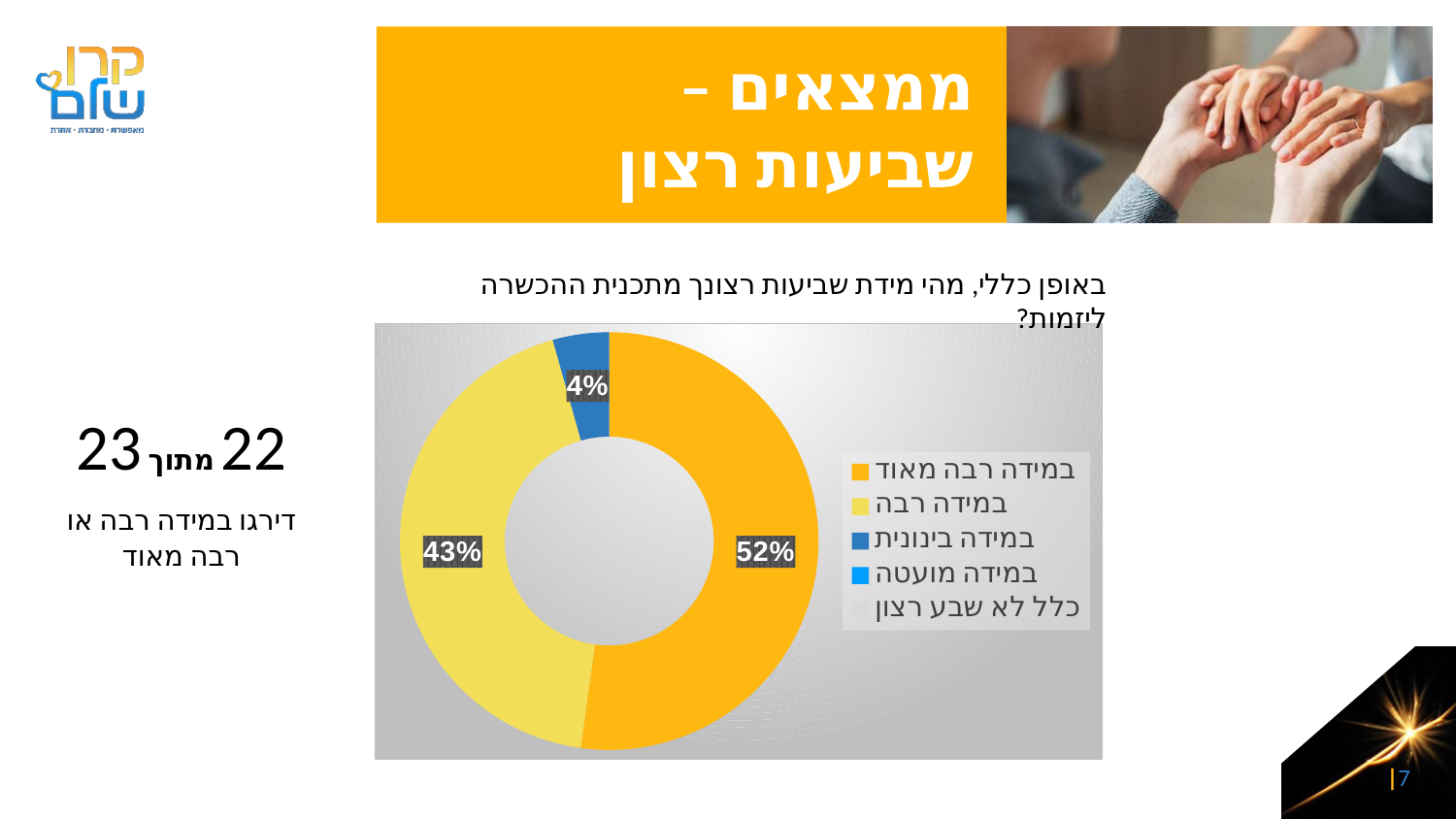
Which is larger: the share for במידה רבה מאוד or the share for במידה רבה? במידה רבה מאוד Which response category has the largest share of the chart? במידה רבה מאוד What colour is the slice representing במידה רבה מאוד? Orange Which labelled slice has the smallest share of the chart? במידה בינונית (4%) What type of chart is shown on the slide? Pie (donut) chart How many entries does the chart legend list? 5 What share of respondents answered במידה בינונית (to a moderate extent)? 4% How many slices with data labels are shown in the chart? 3 What share of respondents answered במידה רבה מאוד (to a very large extent)? 52% What share of respondents answered במידה רבה (to a large extent)? 43% What is the difference in percentage points between the במידה רבה מאוד slice and the במידה רבה slice? 9 percentage points What is the combined share of the במידה רבה מאוד and במידה רבה slices? 95%